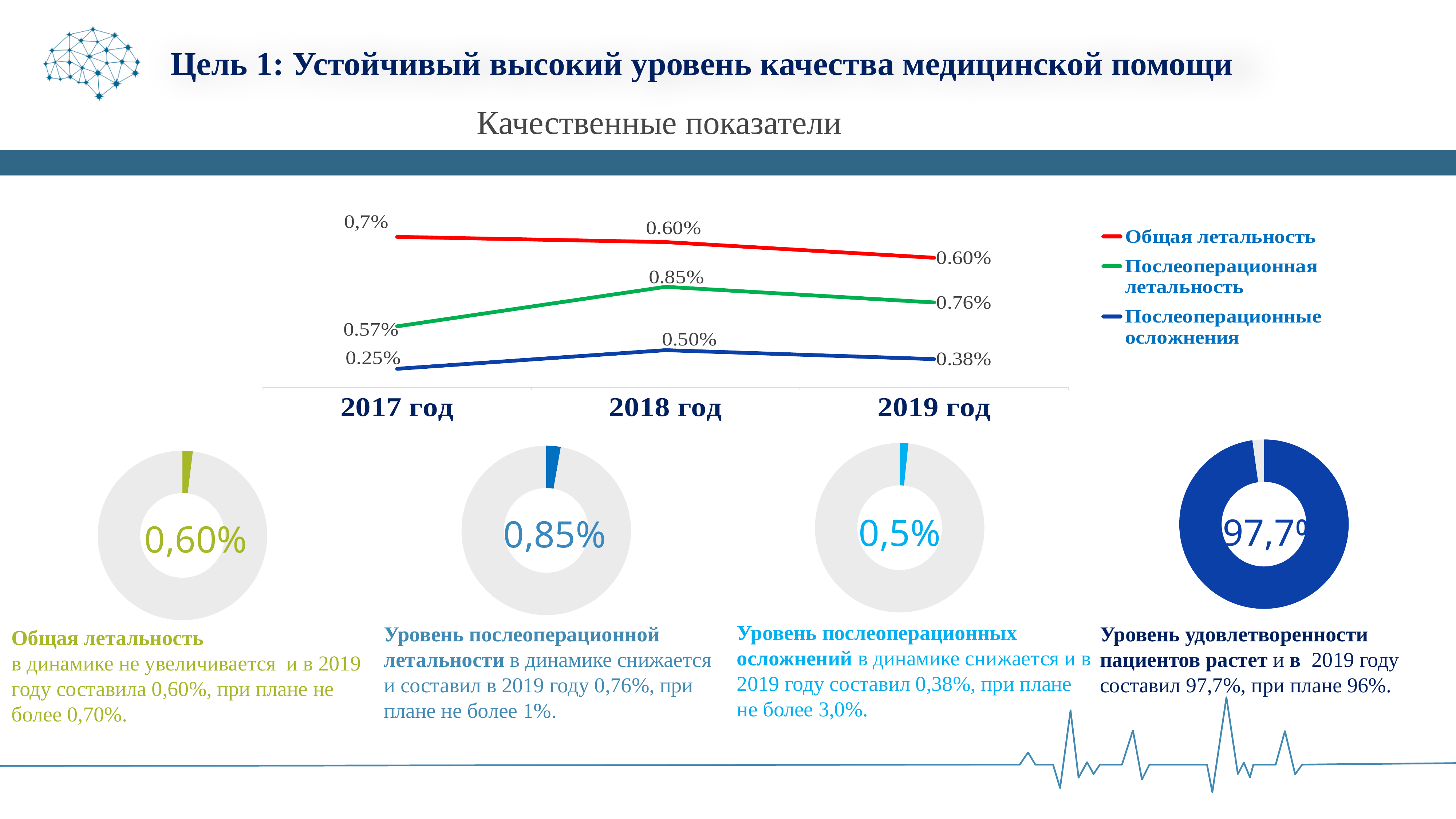
In the top line chart, what is the value of Послеоперационные осложнения in 2017 год? 0.25% In the top line chart, what is the difference between Послеоперационные осложнения in 2018 год and in 2019 год? 0.12% In the top line chart, in which year is Послеоперационная летальность highest? 2018 год In the top line chart, what is the value of Общая летальность in 2019 год? 0.60% What kind of chart is the top chart showing values for 2017, 2018 and 2019? line chart What value is shown in the centre of the second donut chart from the left at the bottom of the slide? 0,85% In the top line chart, which is larger in 2019 год: Послеоперационная летальность or Общая летальность? Послеоперационная летальность In the top line chart, in which year is Послеоперационные осложнения lowest? 2017 год In the top line chart, how many years are shown on the x axis? 3 In the top line chart, does Общая летальность rise or fall from 2017 год to 2019 год? fall In the top line chart, how many series does the legend list? 3 In the top line chart, what is the value of Послеоперационная летальность in 2018 год? 0.85%